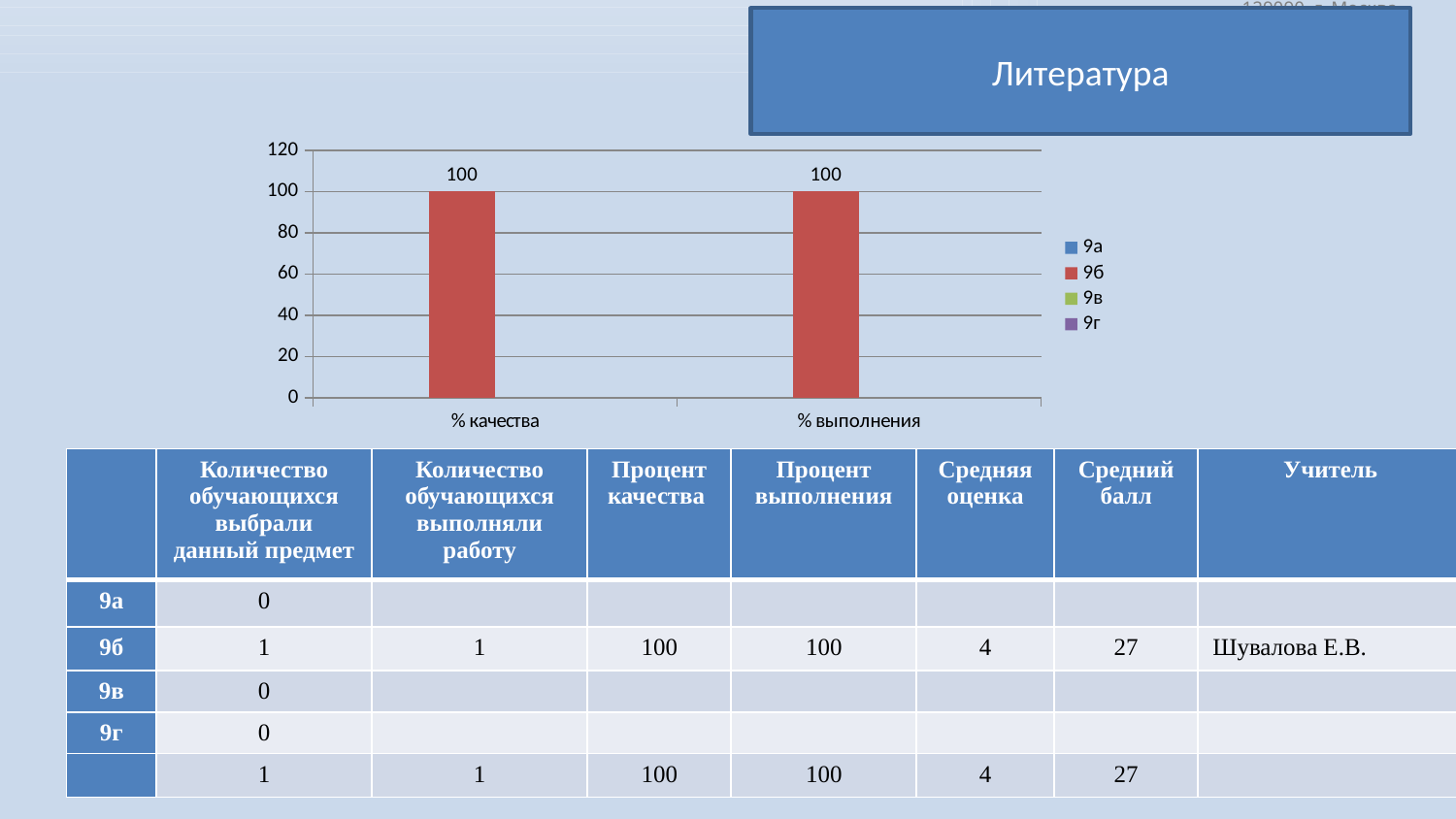
What type of chart is shown on the slide? bar chart What is the value of the 9б bar for % выполнения? 100 How many series does the chart legend list? 4 How many categories are shown on the x axis of the chart? 2 What are the two category labels on the x axis of the chart? % качества, % выполнения What is the difference between the 9б values for % качества and % выполнения? 0 What is the value of the 9б bar for % качества? 100 Is the 9б value for % качества greater or less than 80? greater What is the highest value shown on the chart's vertical axis? 120 Which series in the legend has visible bars in the chart? 9б Is the 9б value for % выполнения greater or less than 120? less